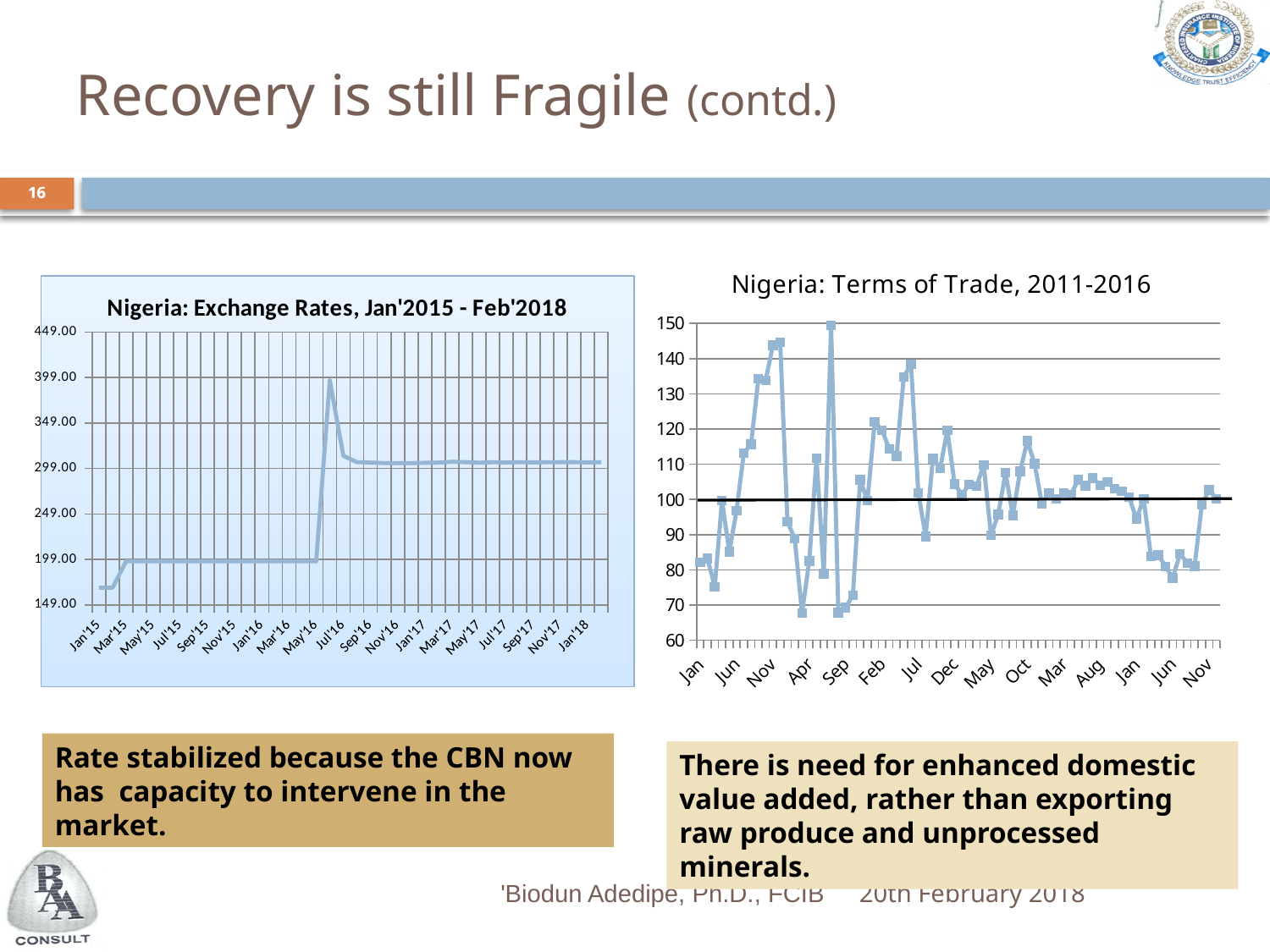
In the 'Nigeria: Exchange Rates' chart, is the highest value on the line greater or less than 349.00? greater In the 'Nigeria: Exchange Rates' chart, does the exchange rate overall rise or fall from Jan'15 to Jan'18? Rise In the 'Nigeria: Exchange Rates' chart, is the value for Jan'18 greater or less than 299.00? greater What kind of chart is the right chart titled 'Nigeria: Terms of Trade, 2011-2016'? Line chart In the 'Nigeria: Terms of Trade, 2011-2016' chart, at what value is the horizontal black reference line drawn? 100 In the 'Nigeria: Terms of Trade, 2011-2016' chart, is the first value (Jan) greater or less than 90? less What kind of chart is the left chart titled 'Nigeria: Exchange Rates, Jan'2015 - Feb'2018'? Line chart